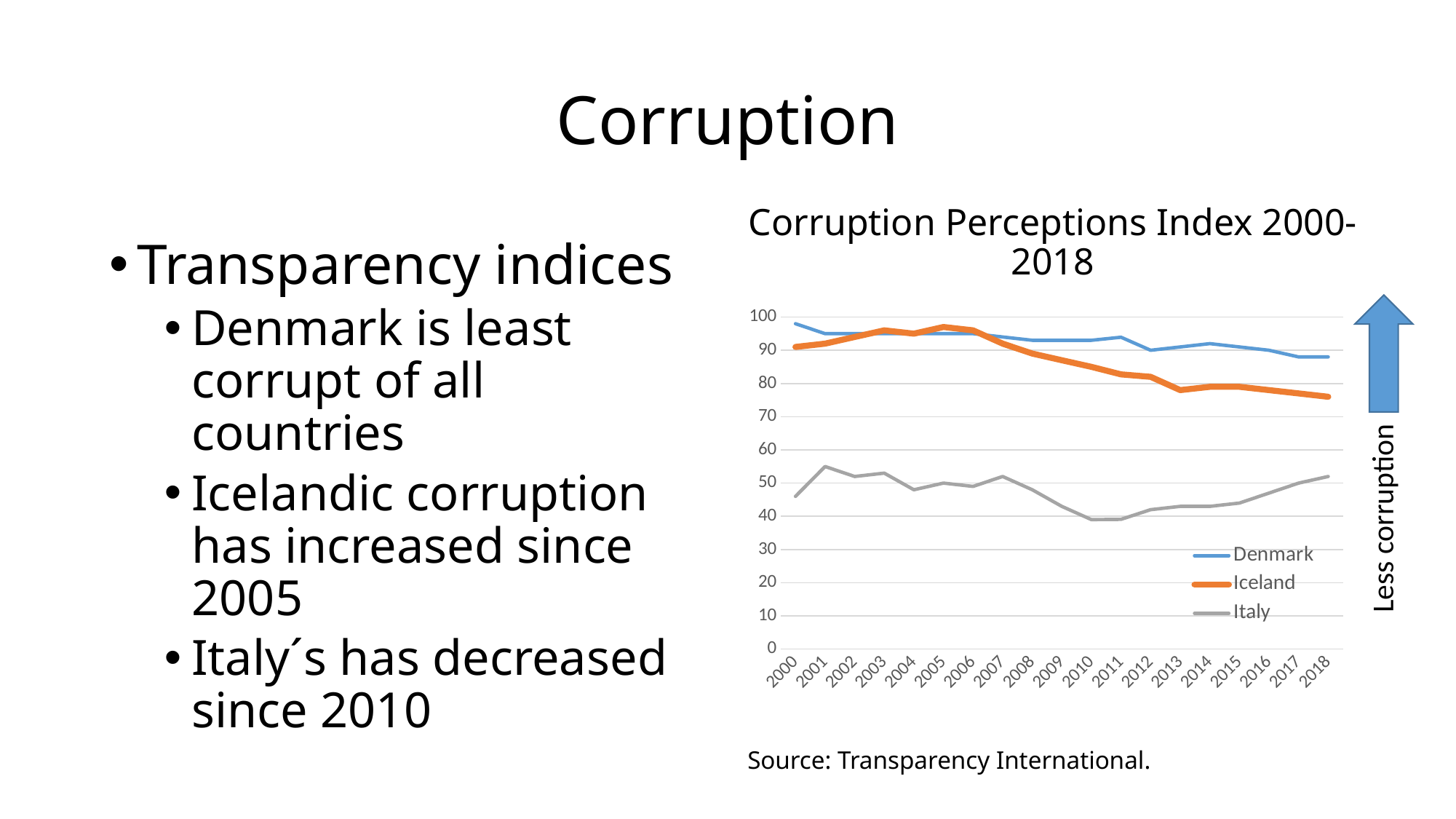
In 2018, which is larger, the value for Denmark or the value for Iceland? Denmark Is the value for Denmark in 2000 greater or less than 90? greater Which country has the lowest values across the whole period in the chart? Italy Does the value for Italy rise or fall between 2010 and 2018? rise How many years are plotted along the x axis of the chart? 19 Which series is drawn in orange in the chart? Iceland What is the title of the chart? Corruption Perceptions Index 2000-2018 Is the value for Iceland in 2018 greater or less than 80? less How many series does the chart legend list? 3 Does the value for Iceland rise or fall between 2005 and 2018? fall What kind of chart is shown on the slide? line chart Which country has the highest value in 2018? Denmark